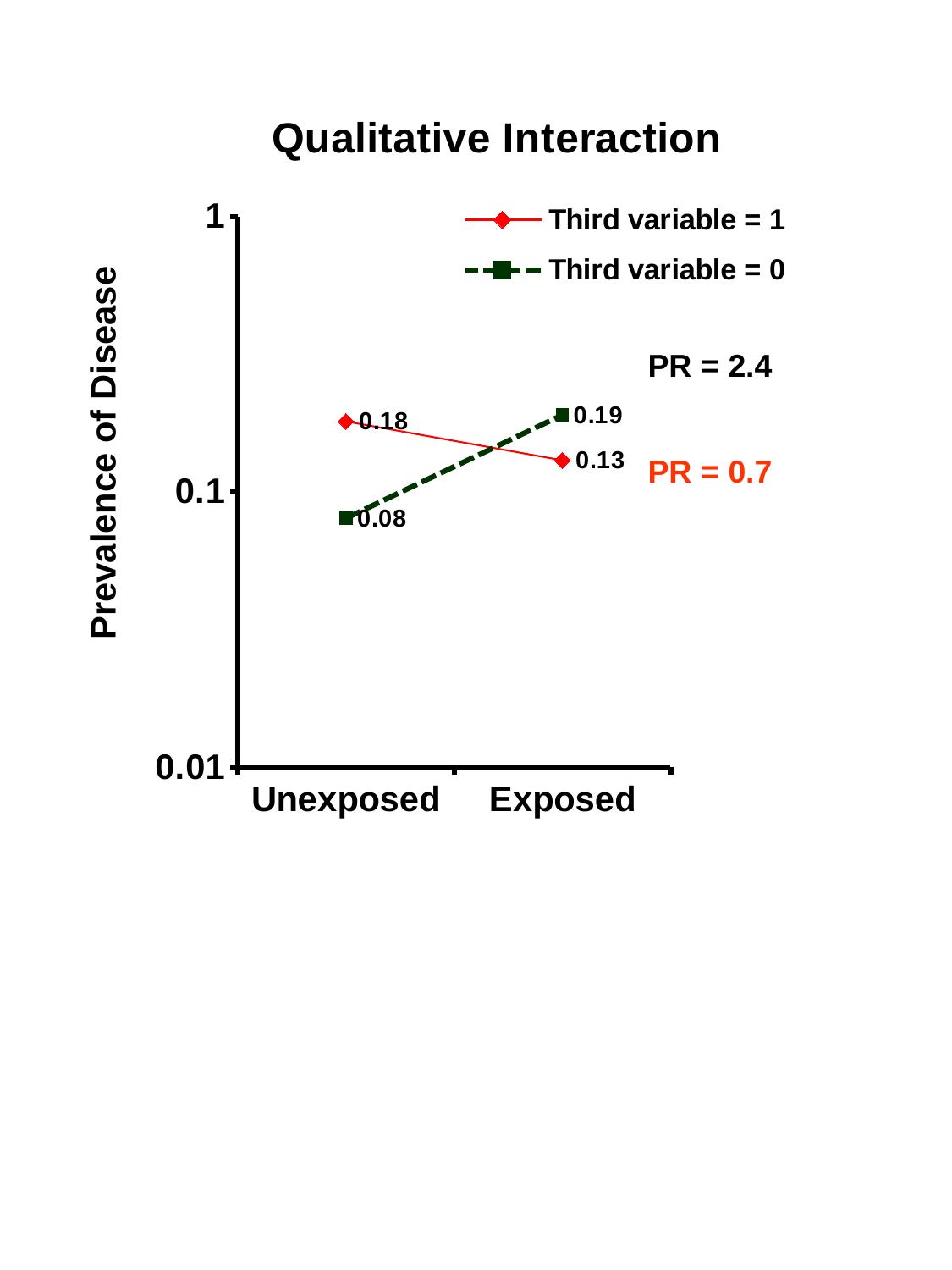
What is the prevalence of disease for Third variable = 1 in the Unexposed group? 0.18 What is the title of the chart? Qualitative Interaction What kind of chart is shown on the slide? line chart What is the prevalence of disease for Third variable = 0 in the Exposed group? 0.19 What is the prevalence of disease for Third variable = 1 in the Exposed group? 0.13 What is the difference in prevalence between Unexposed and Exposed for the Third variable = 1 series? 0.05 Does the prevalence for Third variable = 0 rise or fall from Unexposed to Exposed? rise How many series does the legend list? 2 Does the prevalence for Third variable = 1 rise or fall from Unexposed to Exposed? fall What is the prevalence of disease for Third variable = 0 in the Unexposed group? 0.08 In the Unexposed group, which series has the higher prevalence, Third variable = 1 or Third variable = 0? Third variable = 1 Which group has the lowest prevalence for the Third variable = 0 series? Unexposed